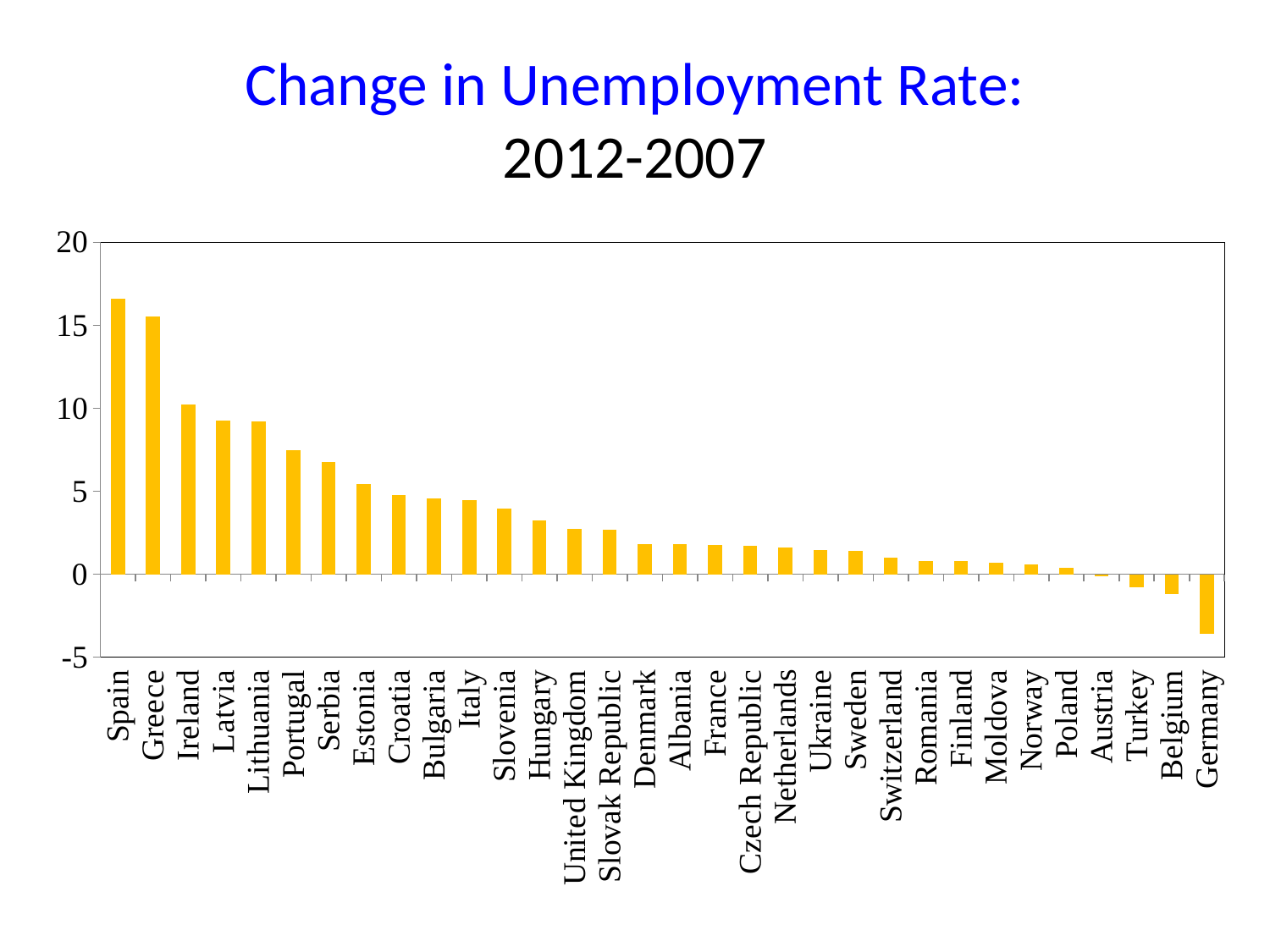
Which has a larger change in unemployment rate, Ireland or Latvia? Ireland Is the value for Spain greater or less than 15? greater Which country has the lowest change in unemployment rate? Germany What kind of chart is shown on the slide? bar chart How many countries are shown on the chart? 32 Is the value for Germany greater or less than 0? less What is the title of the chart? Change in Unemployment Rate: 2012-2007 Which country has the highest change in unemployment rate? Spain Is the value for Latvia greater or less than 10? less Do the values rise or fall moving from left to right along the x axis? fall